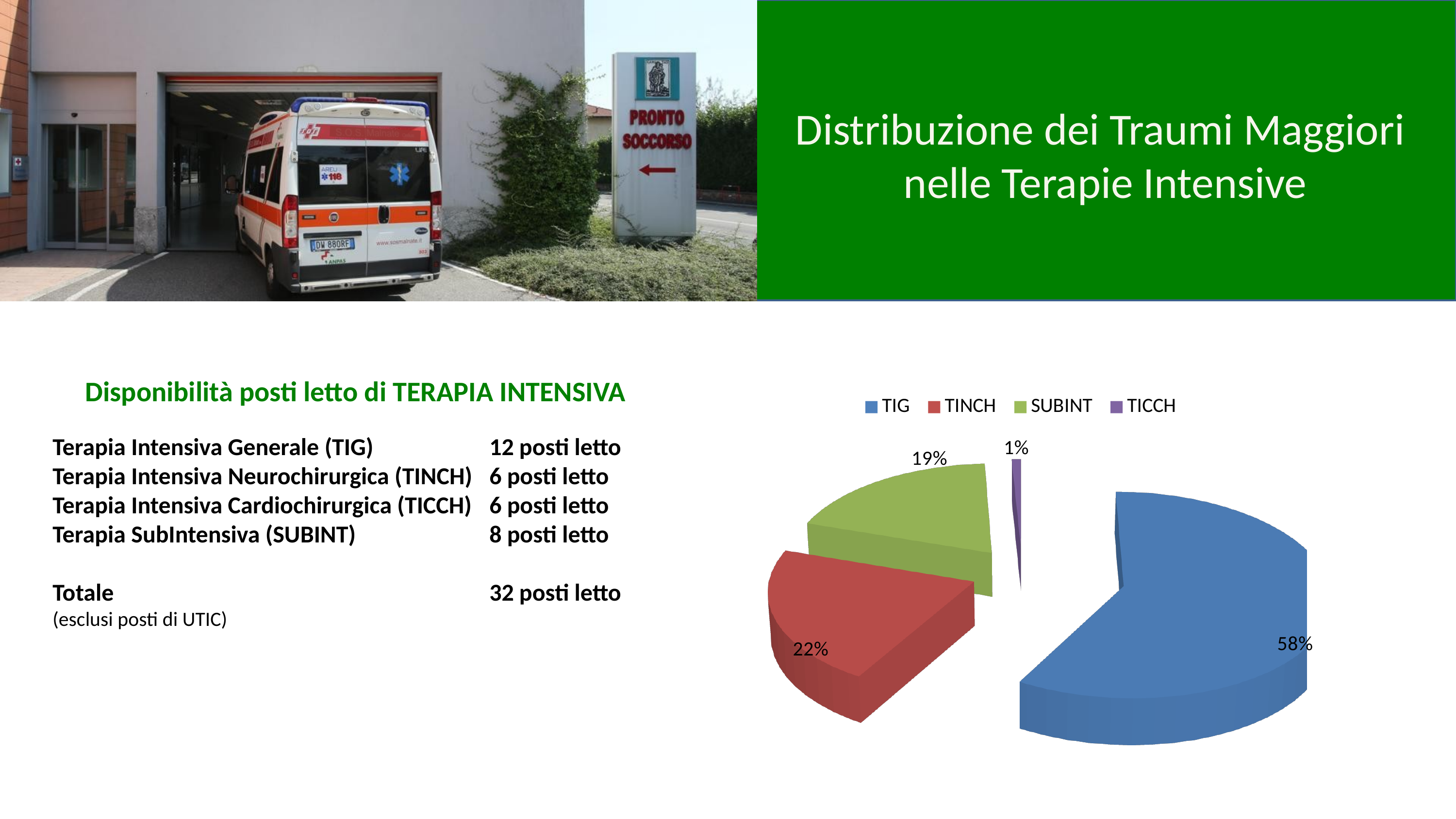
Which colour represents SUBINT in the pie chart? Green Which category has the smallest slice of the pie? TICCH Which slice is larger, TINCH or SUBINT? TINCH Which category has the largest slice of the pie? TIG What share of the pie does TIG have? 58% What is the difference in percentage points between the TINCH and SUBINT slices? 3 What share of the pie does TICCH have? 1% What kind of chart is shown on the slide? Pie chart How many categories does the pie chart show? 4 What is the difference in percentage points between the TIG and TINCH slices? 36 What share of the pie does TINCH have? 22%